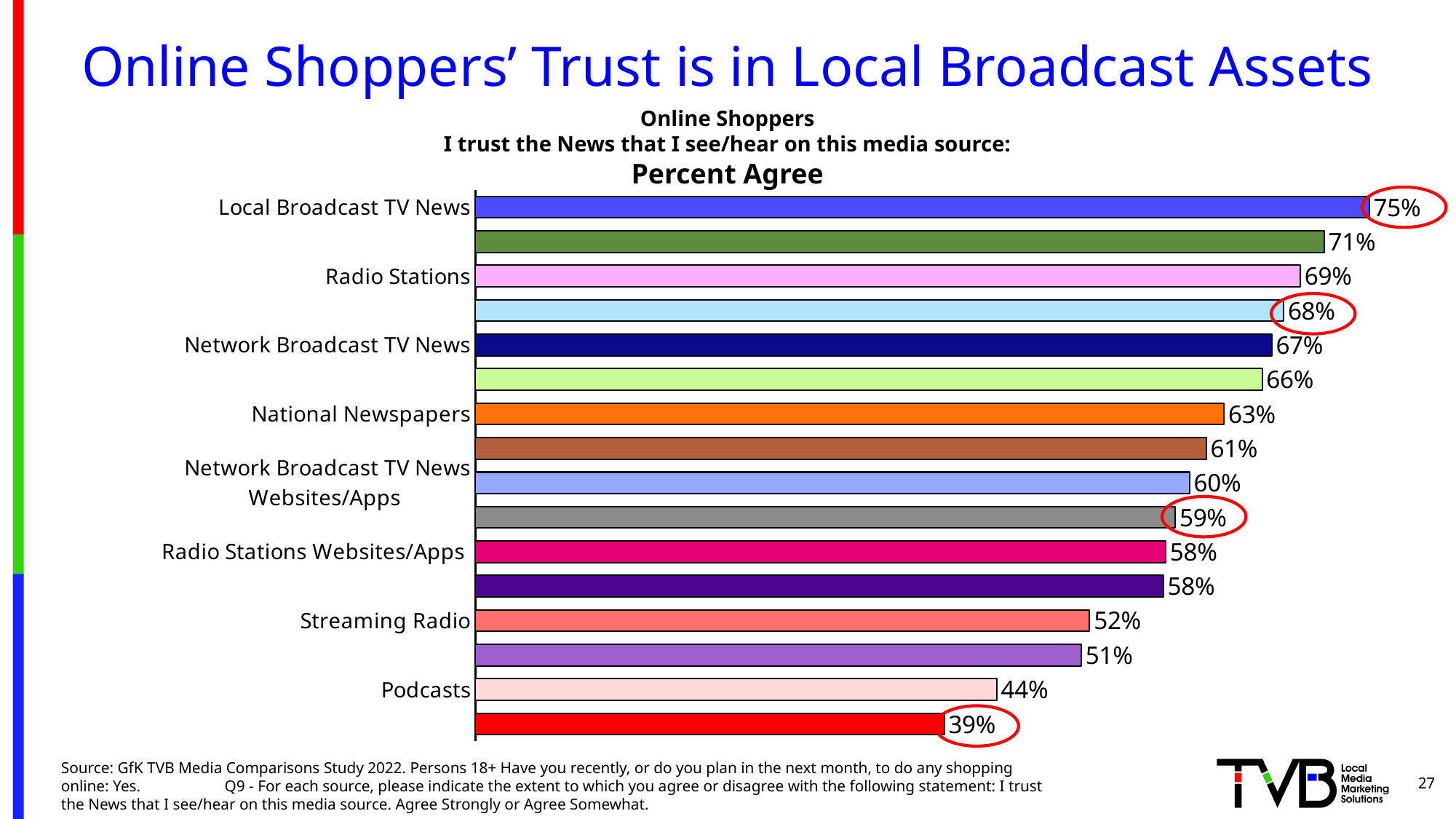
What is the Percent Agree value for National Newspapers? 63% What is the Percent Agree value for Podcasts? 44% What is the Percent Agree value for Network Broadcast TV News? 67% What is the difference in Percent Agree between Network Broadcast TV News Websites/Apps and Radio Stations Websites/Apps? 2% What is the lowest Percent Agree value shown on the chart? 39% How many bars are plotted in the chart? 16 What is the Percent Agree value for Radio Stations? 69% What is the difference in Percent Agree between Local Broadcast TV News and Network Broadcast TV News? 8% What percent of online shoppers agree they trust the news on Local Broadcast TV News? 75% Which media source has the highest Percent Agree in the chart? Local Broadcast TV News What type of chart is shown on the slide? Bar chart Which has a higher Percent Agree, Radio Stations or Streaming Radio? Radio Stations